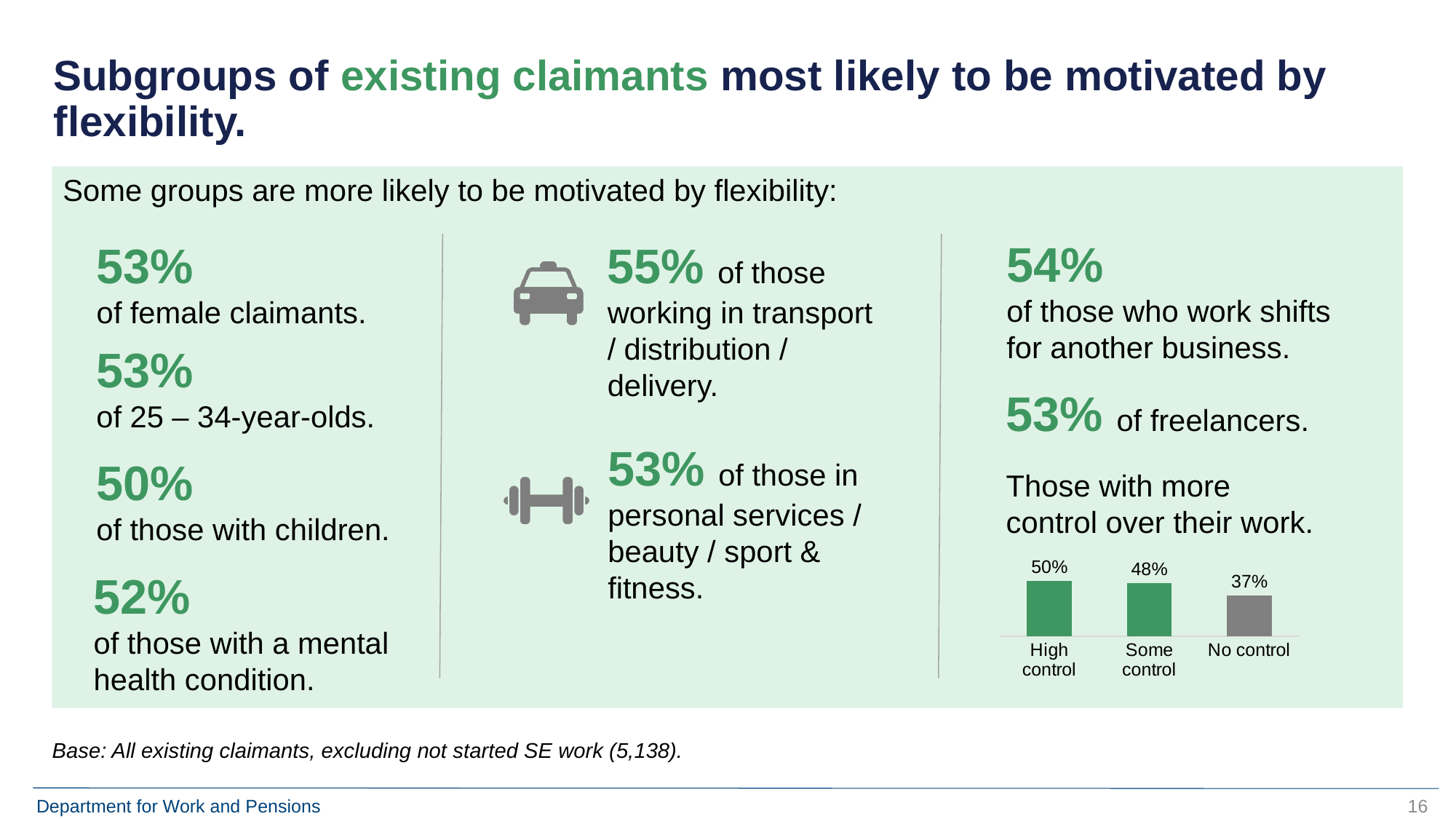
Which bar in the chart is coloured grey rather than green? No control Which category has the lowest value in the bar chart? No control Which category has the highest value in the bar chart? High control What kind of chart is shown on the slide? Bar chart What is the value for Some control in the bar chart? 48% What is the value for No control in the bar chart? 37% What is the difference between the values for Some control and No control? 11% What is the difference between the values for High control and No control? 13% Do the values in the bar chart rise or fall from High control to No control? Fall Which is larger, the value for Some control or the value for No control? Some control How many categories are shown in the bar chart? 3 What is the value for High control in the bar chart? 50%